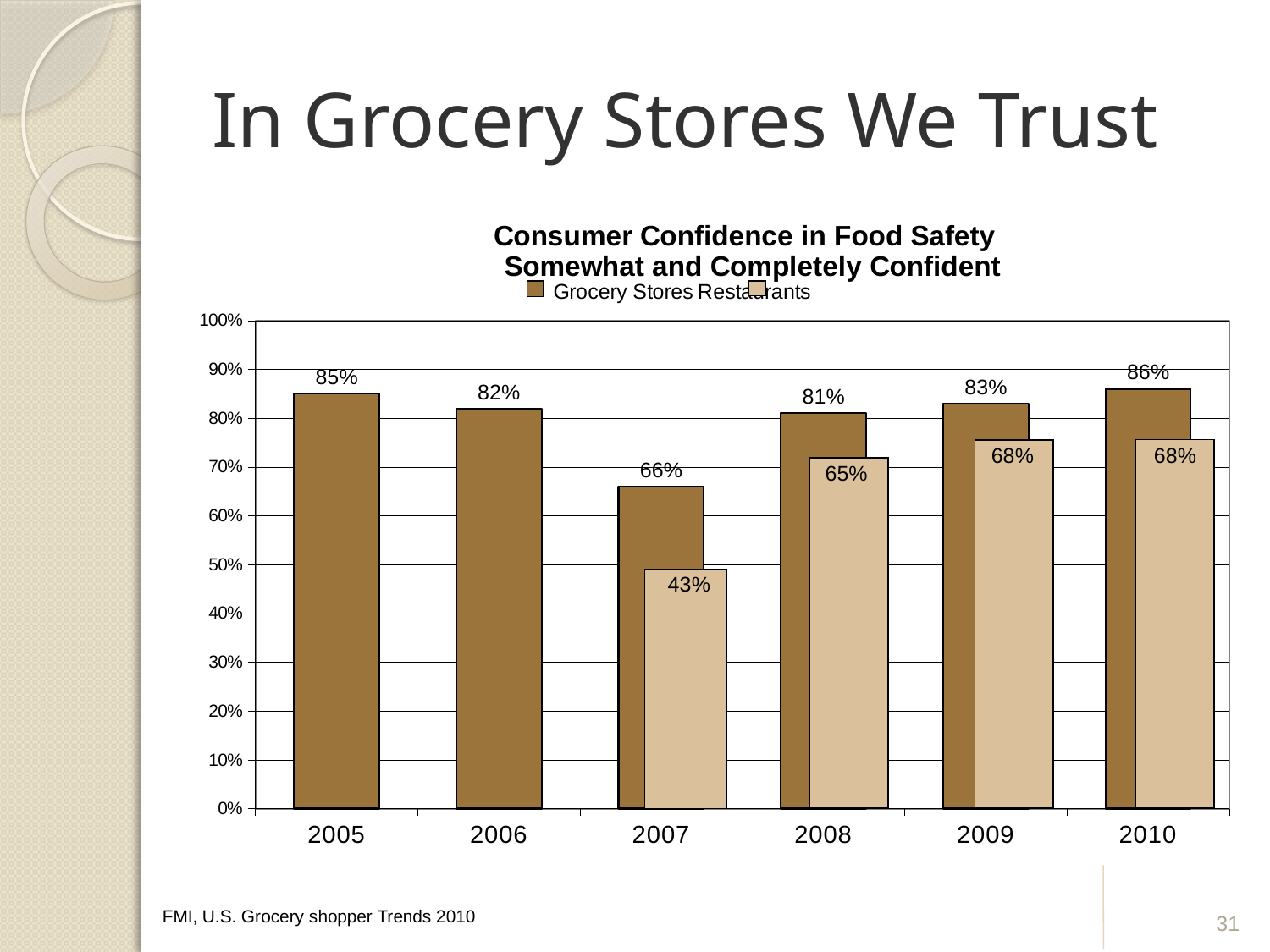
What is the title of the chart? Consumer Confidence in Food Safety Somewhat and Completely Confident What is the Restaurants value for 2007? 43% Which is larger in 2009, the Grocery Stores value or the Restaurants value? Grocery Stores How many years are shown on the x axis? 6 In which year is the Grocery Stores value lowest? 2007 What is the Restaurants value for 2008? 65% How many series does the legend list? 2 What is the Grocery Stores value for 2005? 85% What is the Grocery Stores value for 2010? 86% What is the difference between the Grocery Stores and Restaurants values in 2007? 23% In which year is the Grocery Stores value highest? 2010 What kind of chart is shown on the slide? Bar chart